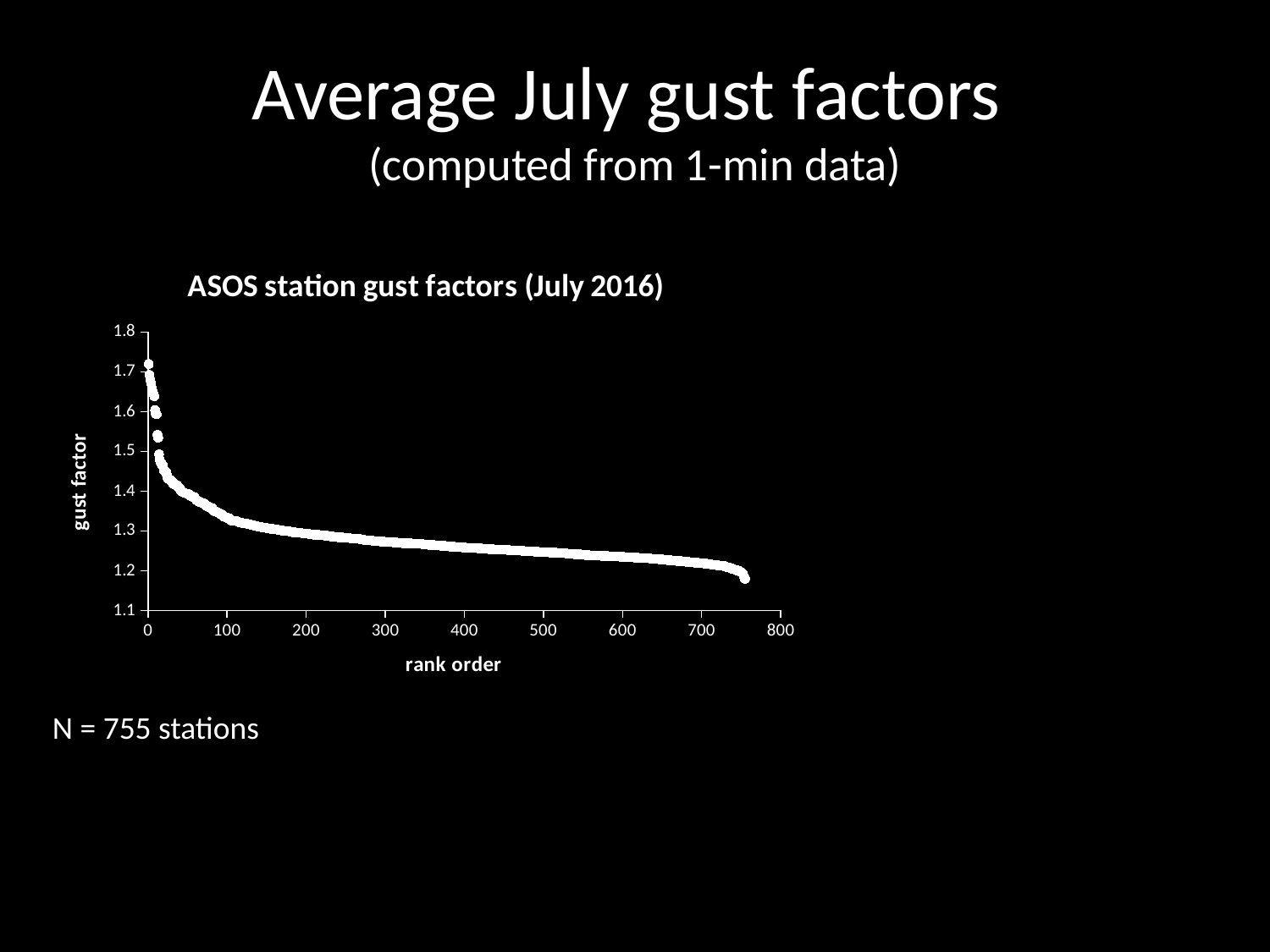
Is the highest gust factor found at the low end or the high end of the rank order axis? low end Is the gust factor at rank order 400 greater or less than 1.2? greater Is the gust factor at rank order 700 greater or less than 1.3? less Is the highest gust factor plotted greater or less than 1.6? greater Do the gust factor values rise or fall as rank order increases along the x axis? fall What kind of chart is shown on the slide? scatter chart How many stations are plotted in the chart? 755 What is the title of the chart? ASOS station gust factors (July 2016) What is the label of the y axis? gust factor